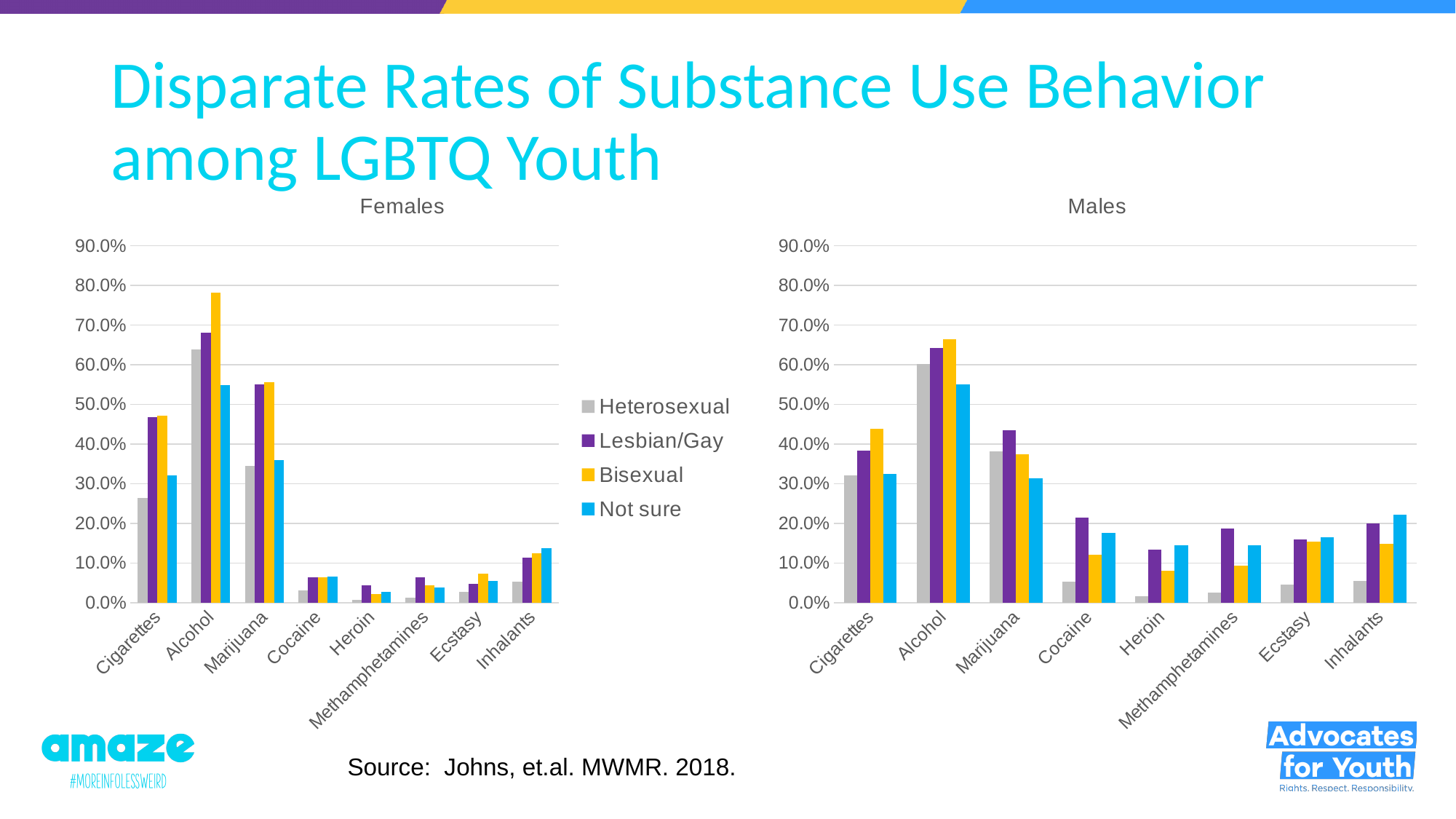
In the Males chart, is the Heterosexual value for Heroin greater or less than 10.0%? less In the Males chart, is the Bisexual value for Alcohol greater or less than 60.0%? greater In the Females chart, which substance has the highest Bisexual value? Alcohol How many substance categories are shown on the x axis of the Males chart? 8 In the Males chart, which substance has the highest Not sure value? Alcohol What kind of chart is the Females chart? Bar chart In the Females chart, is the Bisexual value for Alcohol greater or less than 70.0%? greater In the Males chart, for Cigarettes, which is larger: the Bisexual value or the Lesbian/Gay value? Bisexual How many series does the legend list? 4 What are the titles of the two charts on the slide? Females and Males In the Males chart, for Marijuana, which is larger: the Lesbian/Gay value or the Bisexual value? Lesbian/Gay